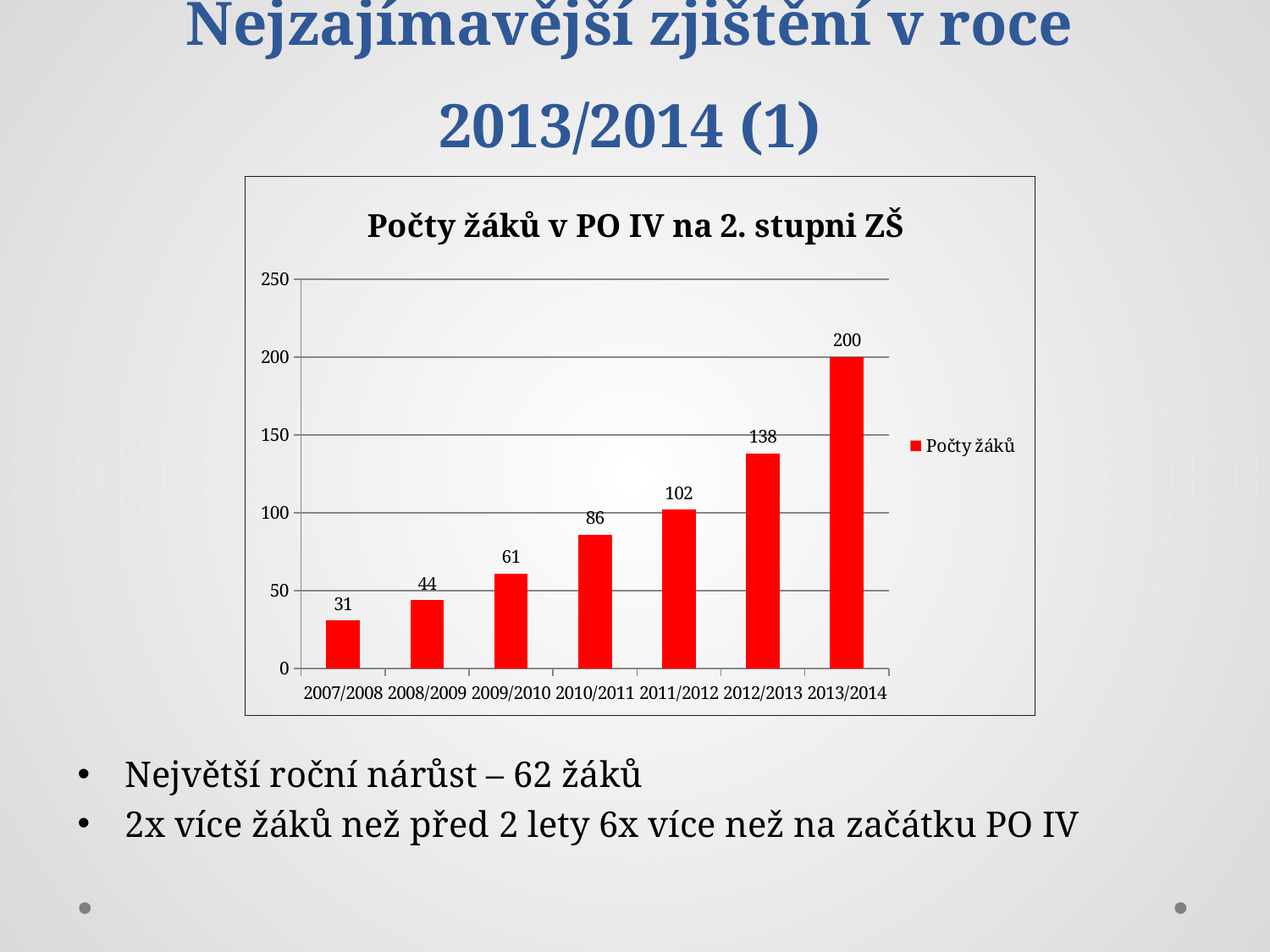
Which school year has the lowest number of pupils? 2007/2008 Is the value for 2012/2013 greater or less than 150? less What is the value for 2009/2010? 61 What is the value for 2013/2014? 200 What is the difference between the values for 2010/2011 and 2008/2009? 42 What is the difference between the values for 2013/2014 and 2012/2013? 62 Which is larger, the value for 2010/2011 or the value for 2011/2012? 2011/2012 How many school years are shown on the x axis? 7 Do the values rise or fall from 2007/2008 to 2013/2014? rise What kind of chart is shown on the slide? bar chart Which school year has the highest number of pupils? 2013/2014 What is the value for 2011/2012? 102